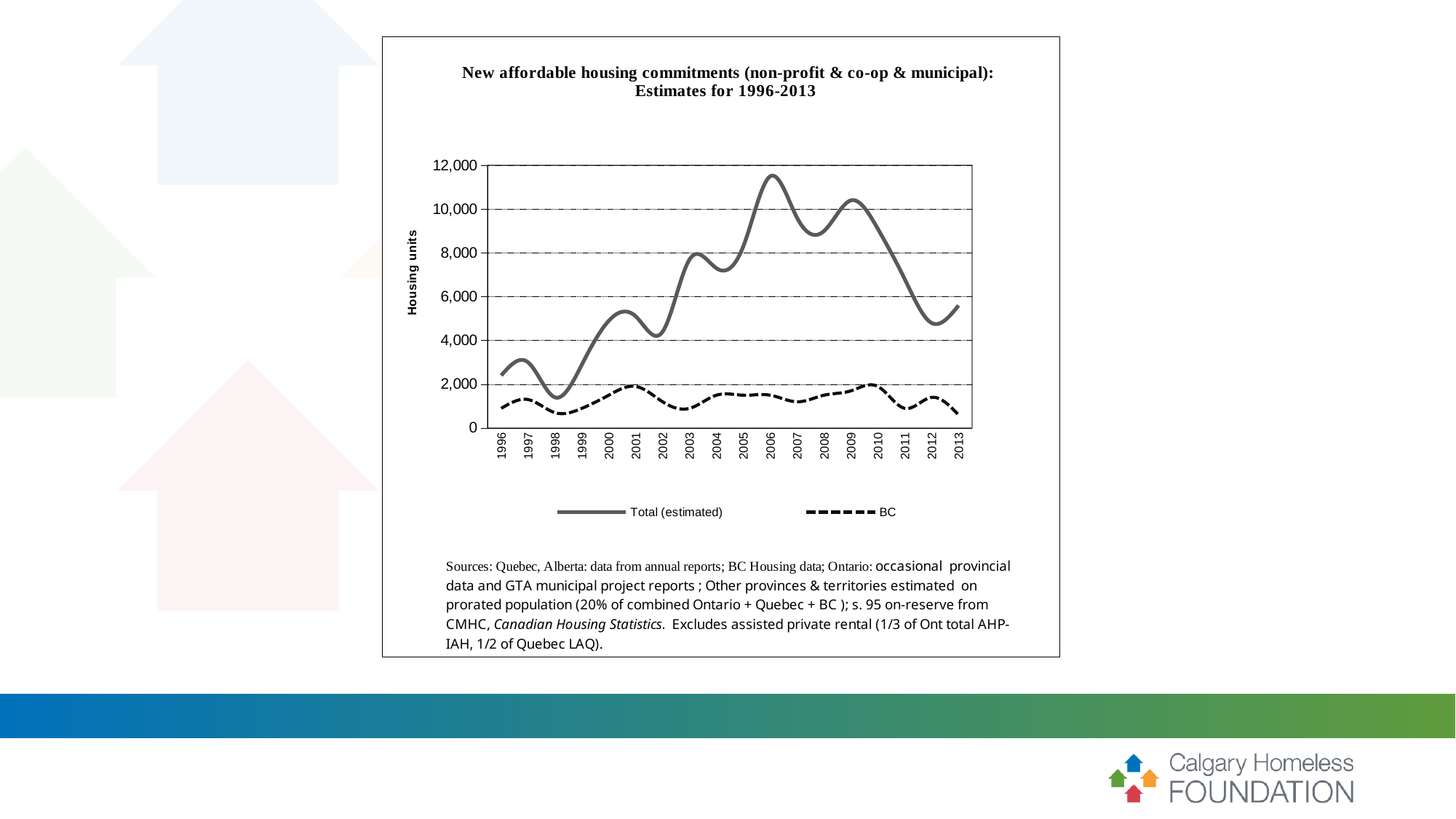
In which year does the Total (estimated) series reach its highest value? 2006 Which is larger in 2006, the Total (estimated) value or the BC value? Total (estimated) Is the Total (estimated) value for 2006 greater or less than 10,000? greater How many years are plotted along the x axis? 18 In which year is the Total (estimated) series at its lowest value? 1998 Is the Total (estimated) value for 2003 greater or less than 6,000? greater How many series does the legend list? 2 What kind of chart is shown on the slide? Line chart Is the BC value for 1998 greater or less than 2,000? less Does the Total (estimated) series rise or fall between 2009 and 2012? Fall What is the label on the y axis? Housing units